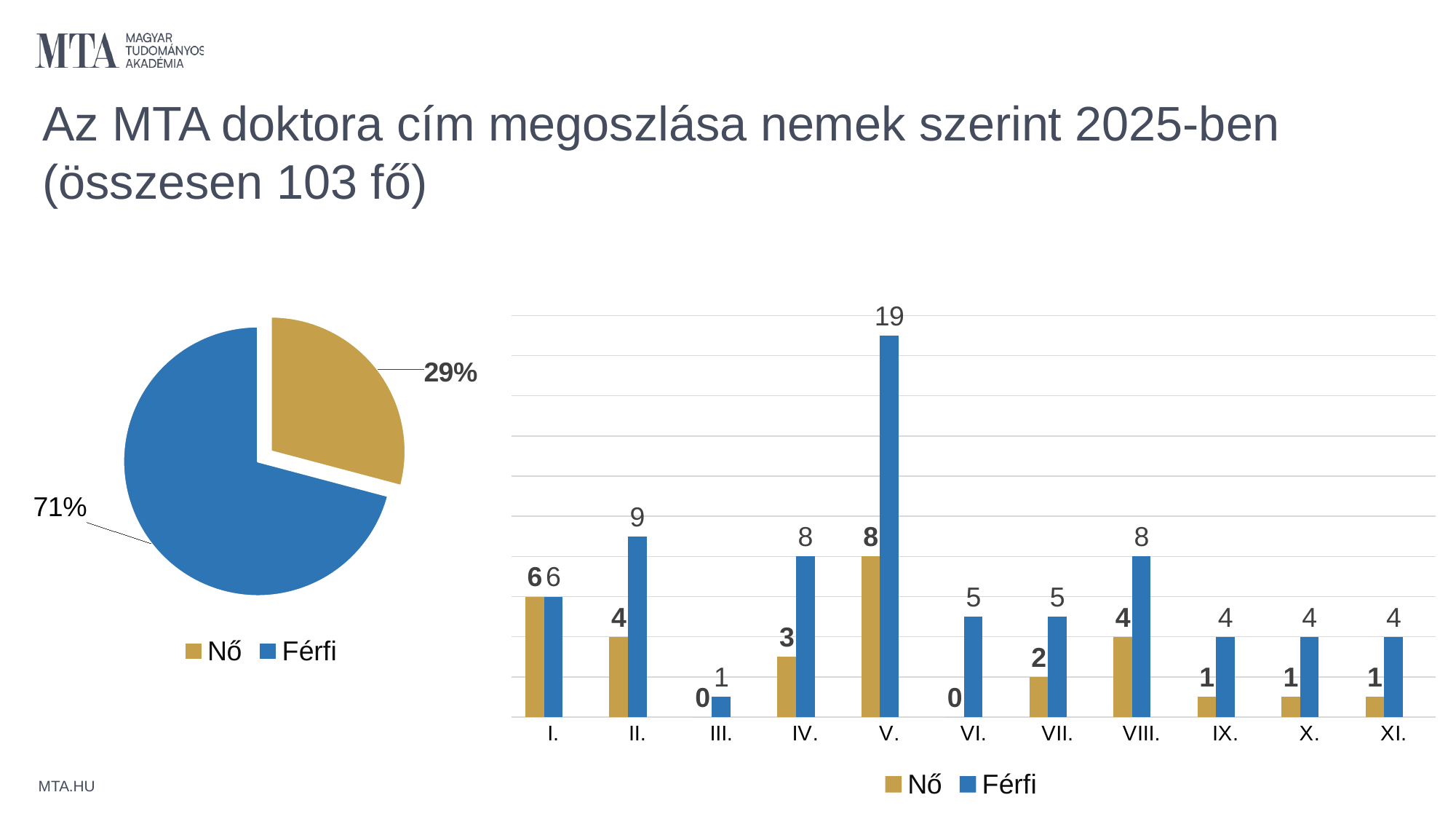
In the pie chart on the left, what share does Nő have? 29% In the bar chart on the right, which is larger for category I., the Nő value or the Férfi value? They are equal (6) In the pie chart on the left, what share does Férfi have? 71% In the bar chart on the right, what is the difference between the Férfi and Nő values for category II.? 5 In the bar chart on the right, how many categories are shown on the x axis? 11 In the bar chart on the right, what is the Nő value for category VIII.? 4 In the bar chart on the right, how many series does the legend list? 2 What kind of chart is the chart on the right? Bar chart In the bar chart on the right, what is the Férfi value for category V.? 19 In the bar chart on the right, what is the total of the Nő and Férfi values for category V.? 27 In the bar chart on the right, which category has the lowest Férfi value? III. In the bar chart on the right, which category has the highest Férfi value? V.